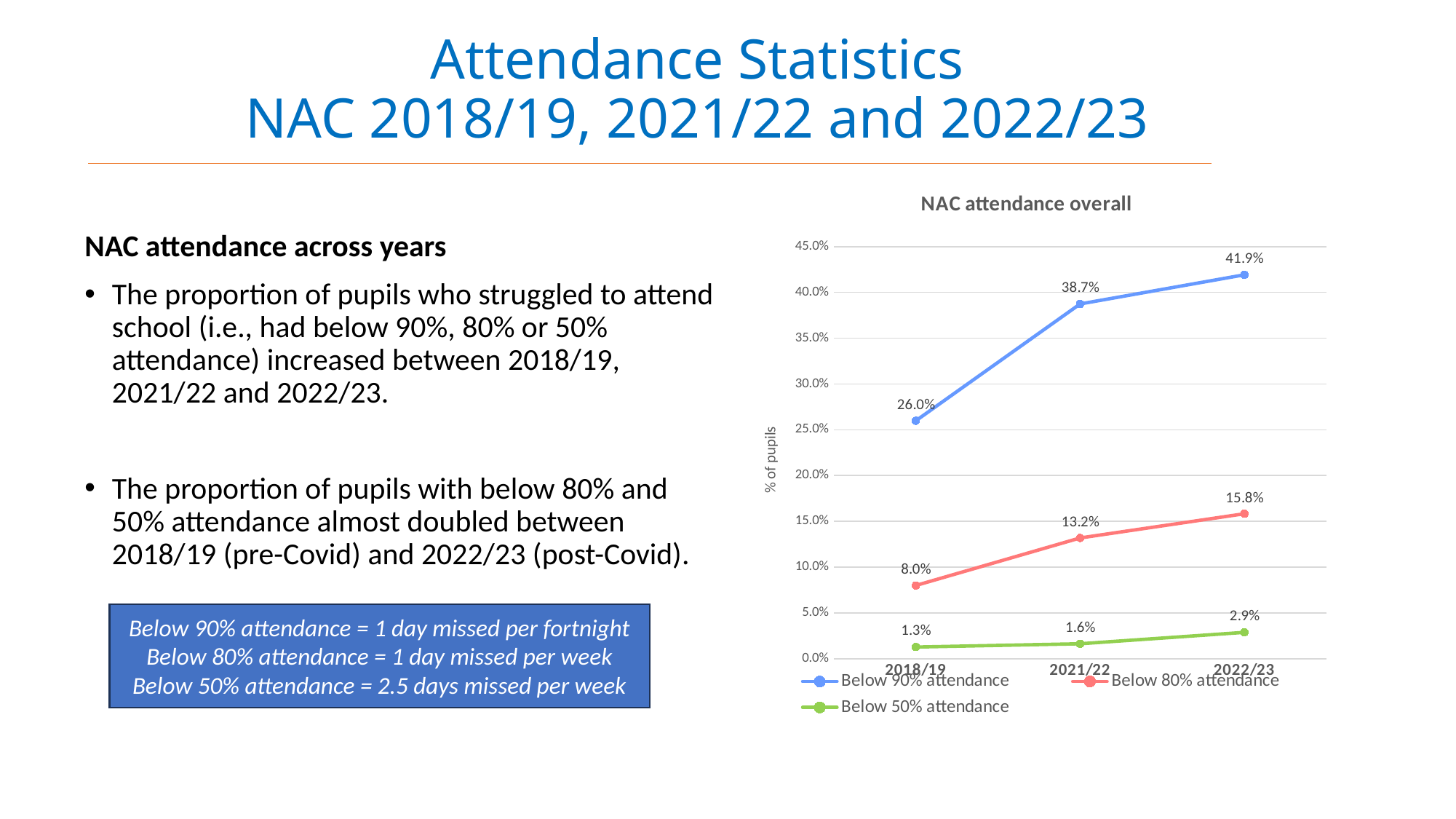
Which is larger: Below 80% attendance in 2021/22 or Below 50% attendance in 2022/23? Below 80% attendance in 2021/22 What is the difference between the Below 90% attendance values for 2022/23 and 2018/19? 15.9% In which year is the Below 80% attendance series lowest? 2018/19 What is the value for Below 50% attendance in 2021/22? 1.6% What is the title of the chart? NAC attendance overall How many years are shown on the x axis? 3 How many series does the legend list? 3 What is the value for Below 80% attendance in 2018/19? 8.0% In which year is the Below 90% attendance series highest? 2022/23 What kind of chart is shown? Line chart What is the value for Below 90% attendance in 2022/23? 41.9% Does the Below 50% attendance series rise or fall from 2018/19 to 2022/23? Rise